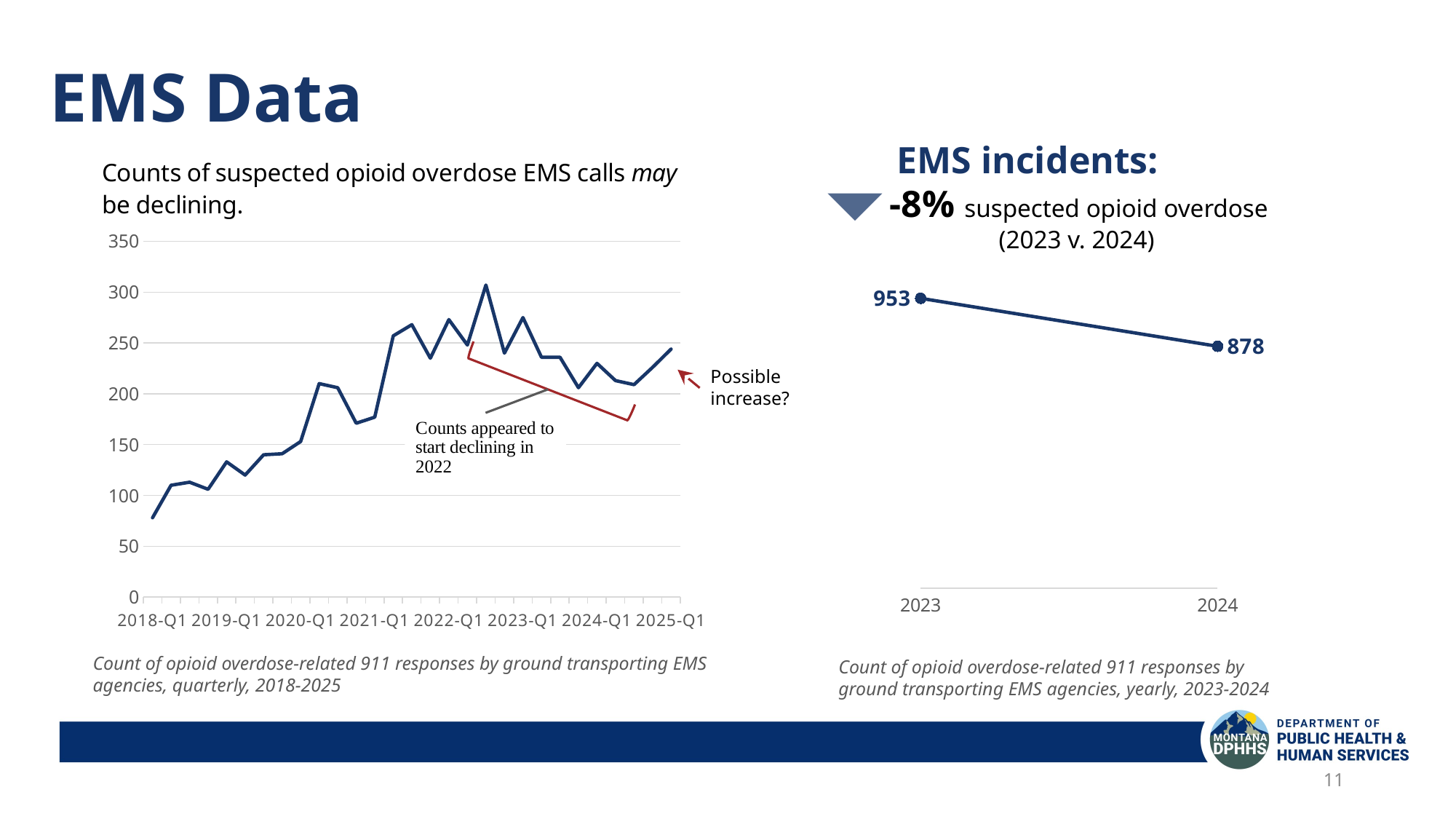
On the right chart 'EMS incidents', what is the value for 2023? 953 What kind of chart is the left chart, 'Count of opioid overdose-related 911 responses by ground transporting EMS agencies, quarterly, 2018-2025'? line chart On the right chart 'EMS incidents', what is the value for 2024? 878 On the right chart 'EMS incidents', what is the difference between the 2023 and 2024 values? 75 On the left quarterly chart, do the values generally rise or fall from 2018-Q1 to 2022-Q1? rise On the left quarterly chart, what is the highest value shown on the y axis? 350 On the right chart 'EMS incidents', which year has the higher value, 2023 or 2024? 2023 On the right chart 'EMS incidents', what percentage change in suspected opioid overdose incidents is stated for 2023 v. 2024? -8% On the left quarterly chart, how many year labels are shown on the x axis? 8 On the left quarterly chart, is the value for 2018-Q1 greater or less than 100? less On the left quarterly chart, is the value for 2025-Q1 greater or less than 200? greater On the left quarterly chart, is the highest value on the line greater or less than 250? greater